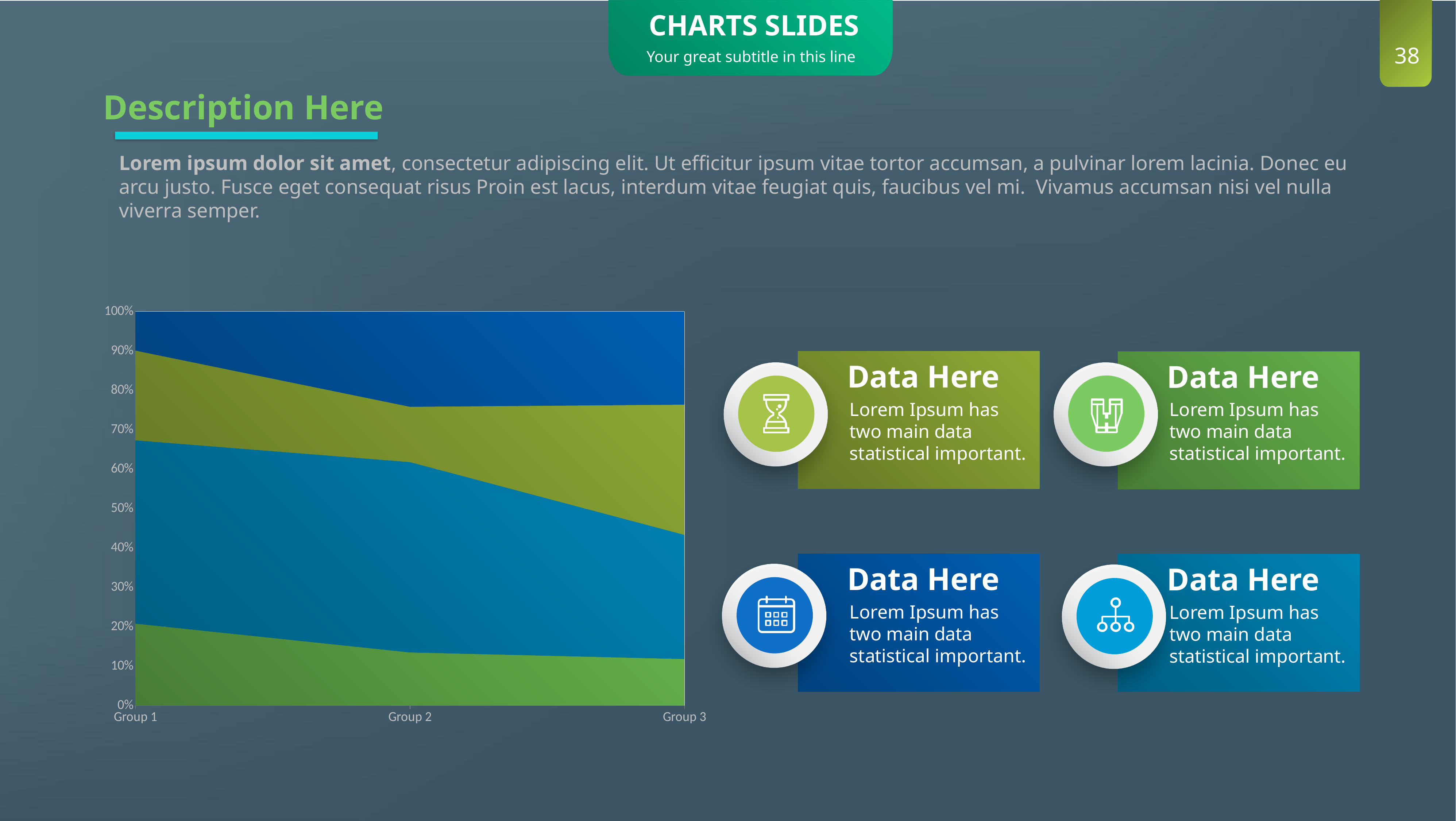
Is the top edge of the light blue area at Group 3 greater or less than 50%? less What kind of chart is shown on the slide? Stacked area chart What is the highest value shown on the y axis of the chart? 100% How many categories are shown on the x axis of the chart? 3 Is the dark blue area at the top of the chart thicker at Group 1 or at Group 2? Group 2 Does the bottom green area of the chart rise or fall from Group 1 to Group 3? Fall Is the top edge of the bottom green area at Group 1 greater or less than 30%? less Is the top edge of the light blue area at Group 1 greater or less than 60%? greater What is the label of the first category on the x axis? Group 1 How many colored series are stacked in the chart? 4